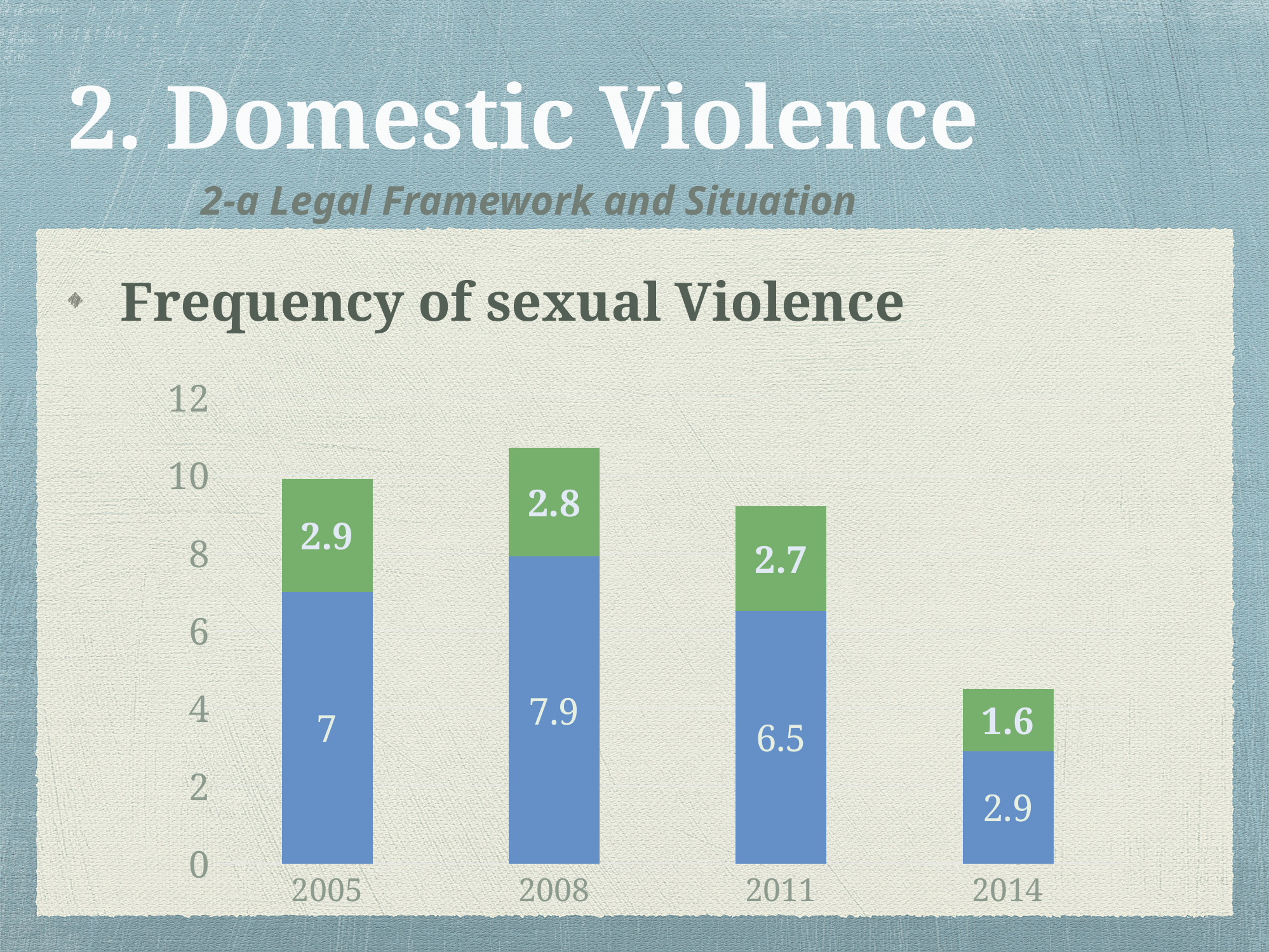
What is the total of the stacked bar for 2014? 4.5 What is the value of the green segment for 2014? 1.6 What is the value of the blue segment for 2008? 7.9 What is the value of the blue segment for 2011? 6.5 Is the blue segment value for 2005 larger than the blue segment value for 2014? Yes How many years are shown on the x axis? 4 Which year has the lowest green segment value? 2014 Which year has the highest blue segment value? 2008 Do the blue segment values rise or fall from 2008 to 2014? Fall What is the total of the stacked bar for 2008? 10.7 What kind of chart is shown on the slide? Stacked bar chart What is the difference between the blue segment values for 2008 and 2011? 1.4